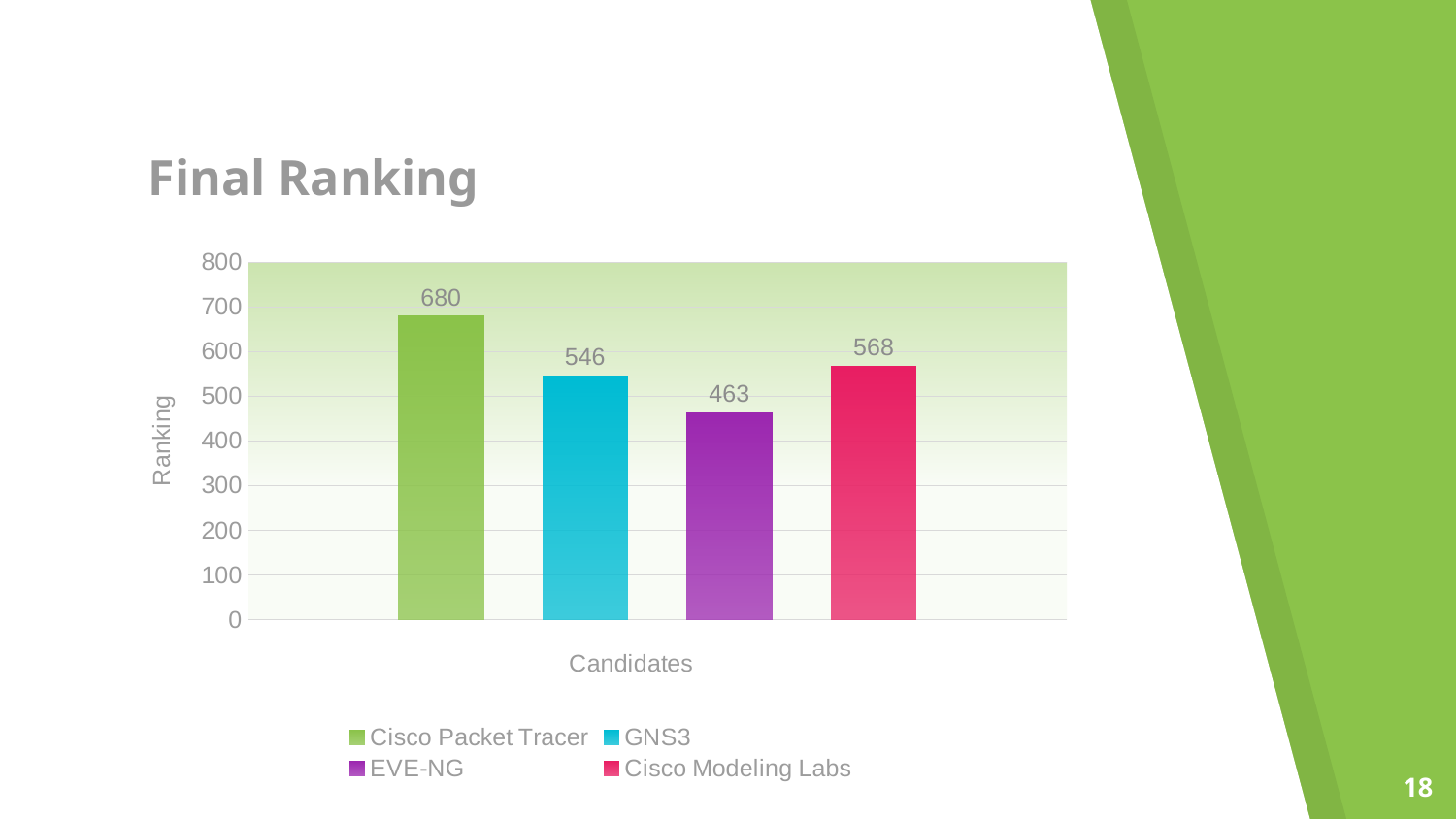
Which candidate has the lowest ranking value? EVE-NG What is the difference between the ranking values of Cisco Packet Tracer and EVE-NG? 217 How many candidates are shown in the chart? 4 What is the ranking value for GNS3? 546 What is the label of the vertical axis of the chart? Ranking What is the difference between the ranking values of Cisco Modeling Labs and GNS3? 22 Which has a higher ranking value, GNS3 or Cisco Modeling Labs? Cisco Modeling Labs What kind of chart is shown on the slide? Bar chart What is the ranking value for Cisco Modeling Labs? 568 What is the ranking value for Cisco Packet Tracer? 680 What is the ranking value for EVE-NG? 463 Which candidate has the highest ranking value? Cisco Packet Tracer